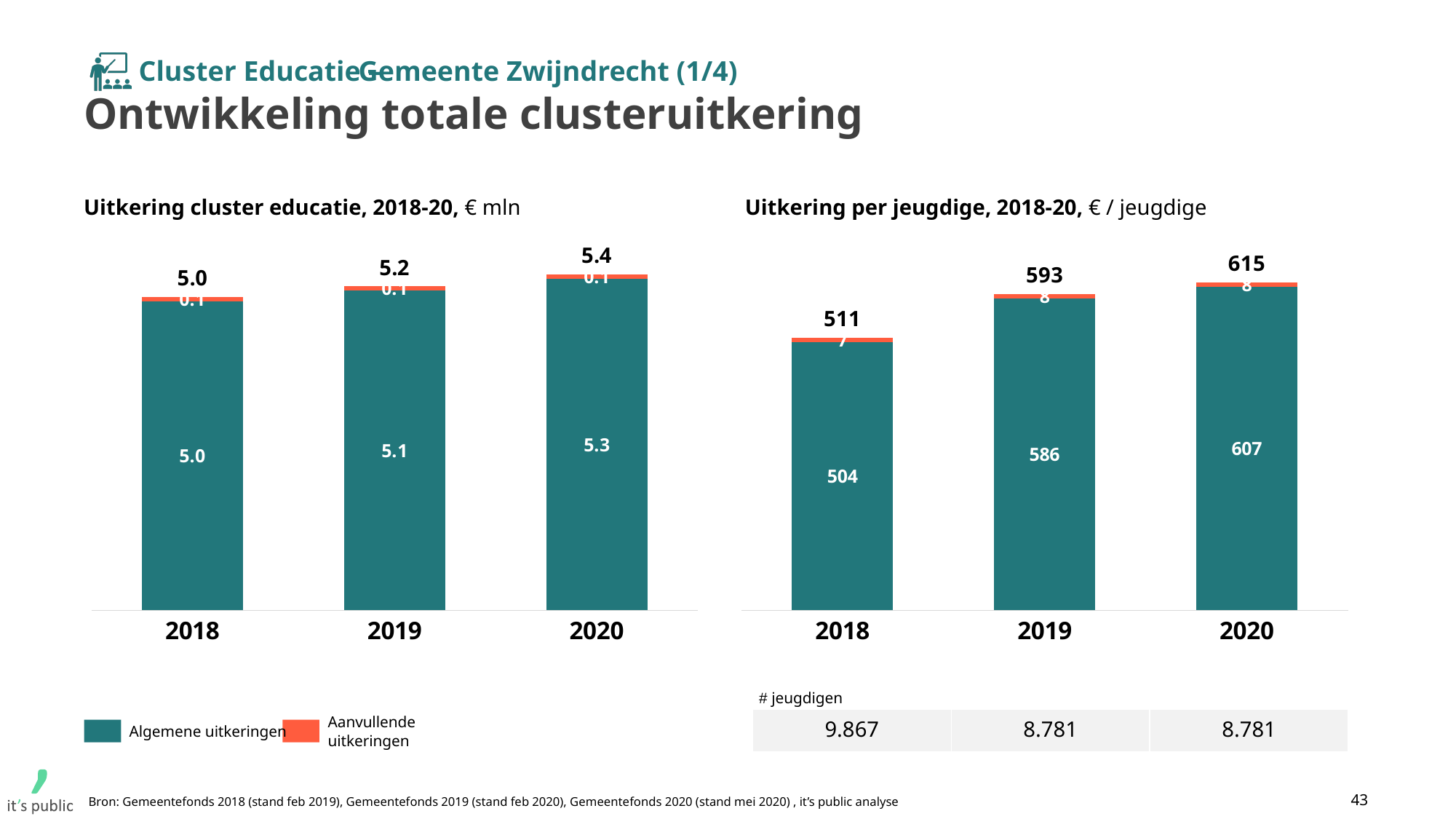
In the chart 'Uitkering cluster educatie, 2018-20', what is the value of Algemene uitkeringen in 2019? 5.1 How many years are shown on the x axis of the chart 'Uitkering per jeugdige, 2018-20'? 3 In the chart 'Uitkering per jeugdige, 2018-20', what is the value of Algemene uitkeringen in 2018? 504 In the chart 'Uitkering cluster educatie, 2018-20', what is the total value for 2020? 5.4 In the chart 'Uitkering cluster educatie, 2018-20', which year has the lowest total? 2018 What type of chart is 'Uitkering cluster educatie, 2018-20'? Stacked bar chart How many series does the legend list for the charts on this slide? 2 In the chart 'Uitkering per jeugdige, 2018-20', what is the difference between the total for 2020 and the total for 2018? 104 In the chart 'Uitkering cluster educatie, 2018-20', is the Algemene uitkeringen value for 2020 larger or smaller than for 2018? larger In the chart 'Uitkering per jeugdige, 2018-20', do the totals rise or fall from 2018 to 2020? rise In the chart 'Uitkering per jeugdige, 2018-20', which year has the highest total? 2020 In the chart 'Uitkering per jeugdige, 2018-20', what is the total value for 2019? 593